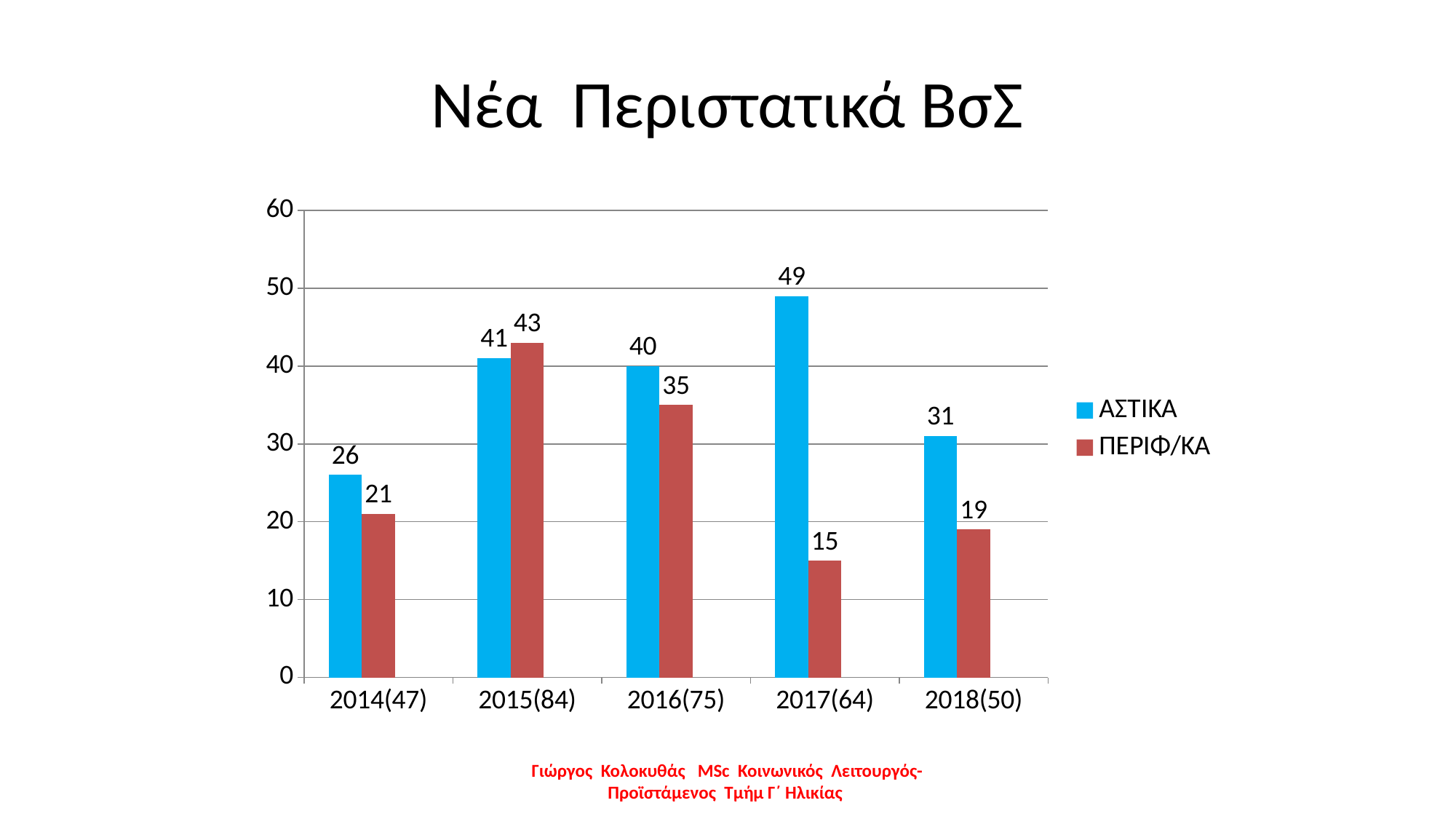
Is the value for ΑΣΤΙΚΑ in 2014(47) greater or less than 30? less Which category has the lowest ΠΕΡΙΦ/ΚΑ value? 2017(64) How many series does the legend list? 2 How many categories are shown on the x axis? 5 What is the value for ΠΕΡΙΦ/ΚΑ in 2018(50)? 19 What is the difference between ΑΣΤΙΚΑ and ΠΕΡΙΦ/ΚΑ in 2017(64)? 34 What is the title of the chart? Νέα Περιστατικά ΒσΣ Which category has the highest ΑΣΤΙΚΑ value? 2017(64) What is the value for ΠΕΡΙΦ/ΚΑ in 2015(84)? 43 What is the value for ΑΣΤΙΚΑ in 2017(64)? 49 What kind of chart is shown on the slide? bar chart Which is larger in 2015(84), ΑΣΤΙΚΑ or ΠΕΡΙΦ/ΚΑ? ΠΕΡΙΦ/ΚΑ